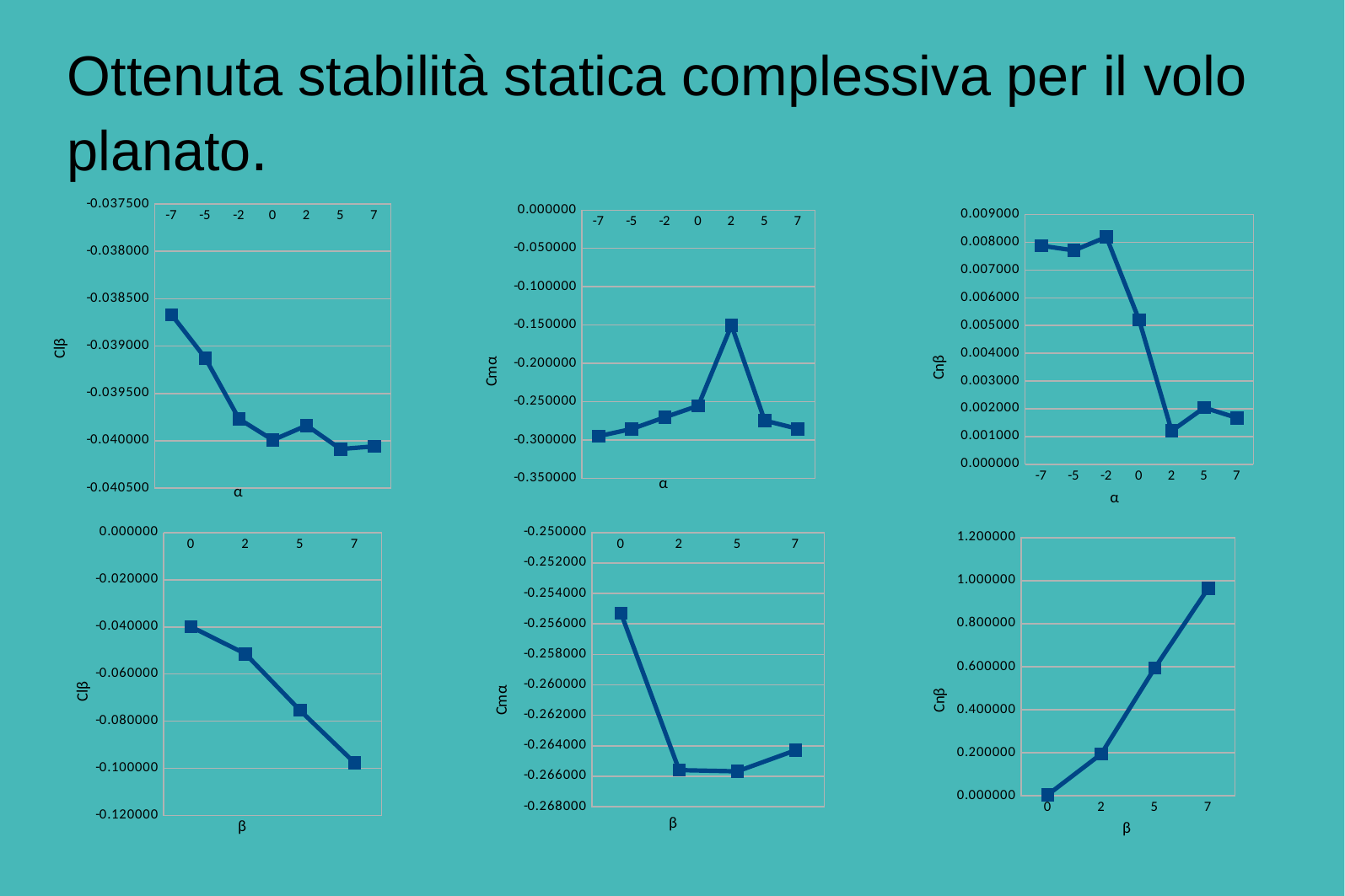
In the top-left chart (Clβ vs α), how many data points are plotted? 7 In the top-right chart (Cnβ vs α), at which α value is Cnβ lowest? 2 In the top-middle chart (Cmα vs α), is the value at α = 2 greater or less than -0.200000? greater In the bottom-middle chart (Cmα vs β), which is larger: the value at β = 0 or the value at β = 2? β = 0 In the top-left chart (Clβ vs α), is the value at α = 5 greater or less than -0.040000? less In the top-middle chart (Cmα vs α), at which α value is Cmα highest? 2 In the bottom-right chart (Cnβ vs β), do the values rise or fall as β increases? rise In the top-left chart (Clβ vs α), do the values generally rise or fall as α increases? fall How many charts are shown on the slide? 6 In the bottom-left chart (Clβ vs β), how many data points are plotted? 4 What type of chart is the top-left chart (Clβ vs α)? line chart